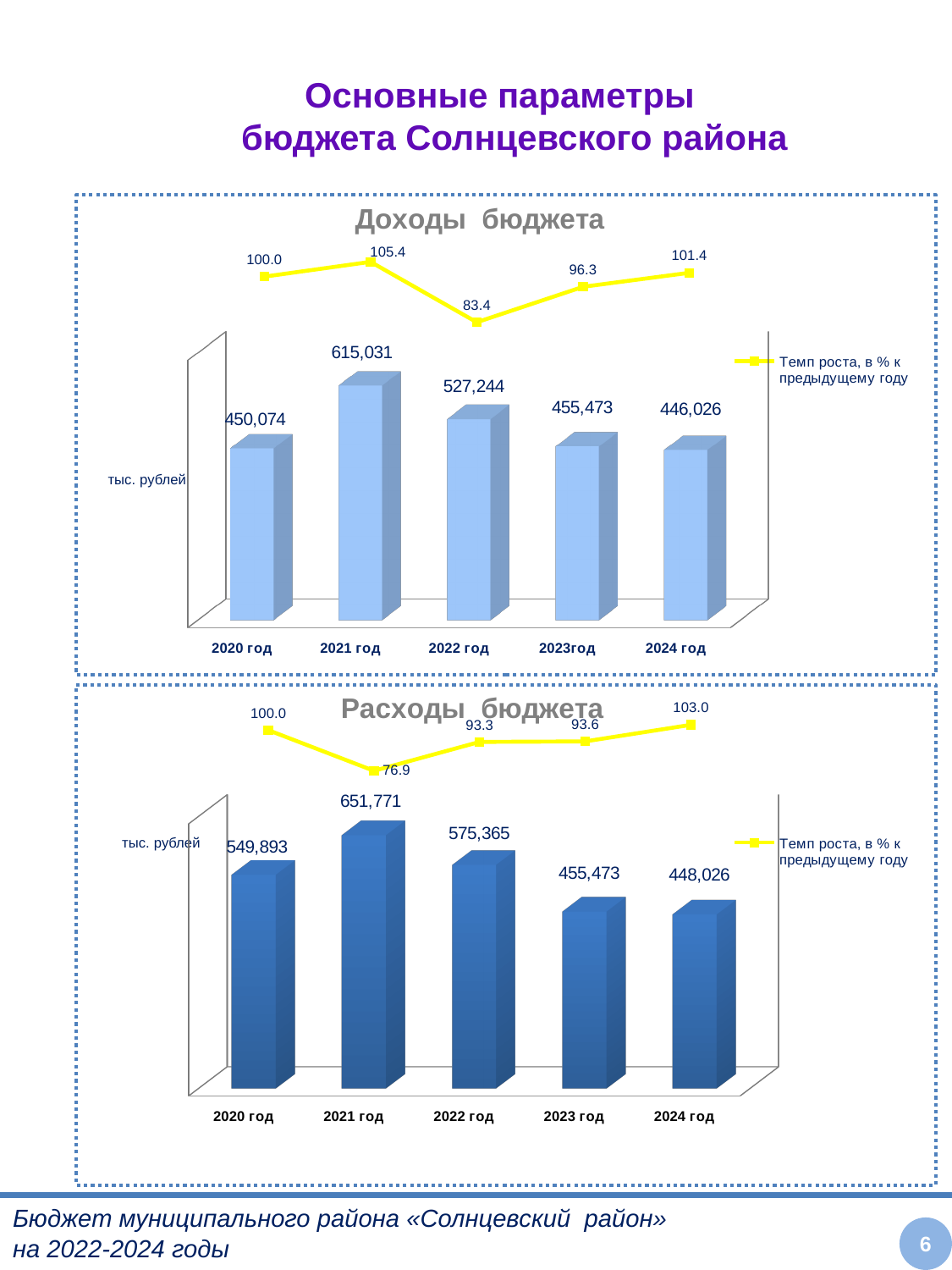
In the 'Расходы бюджета' chart, which is larger: the bar for 2020 год or the bar for 2022 год? 2022 год In the 'Доходы бюджета' chart, which year has the highest bar? 2021 год How many years (categories) are shown on the x axis of the 'Доходы бюджета' chart? 5 In the 'Доходы бюджета' chart, what is the value for 2021 год? 615,031 In the 'Доходы бюджета' chart, what is the growth rate (Темп роста) value for 2022 год? 83.4 In the 'Расходы бюджета' chart, which year has the lowest bar? 2024 год In the 'Доходы бюджета' chart, what is the difference between the 2021 год and 2020 год bar values? 164,957 In the 'Доходы бюджета' chart, which year has the lowest bar? 2024 год What unit is indicated for the bar values in the 'Расходы бюджета' chart? тыс. рублей In the 'Расходы бюджета' chart, what is the value for 2022 год? 575,365 In the 'Расходы бюджета' chart, what is the difference between the 2023 год and 2024 год bar values? 7,447 In the 'Расходы бюджета' chart, what is the growth rate (Темп роста) value for 2021 год? 76.9